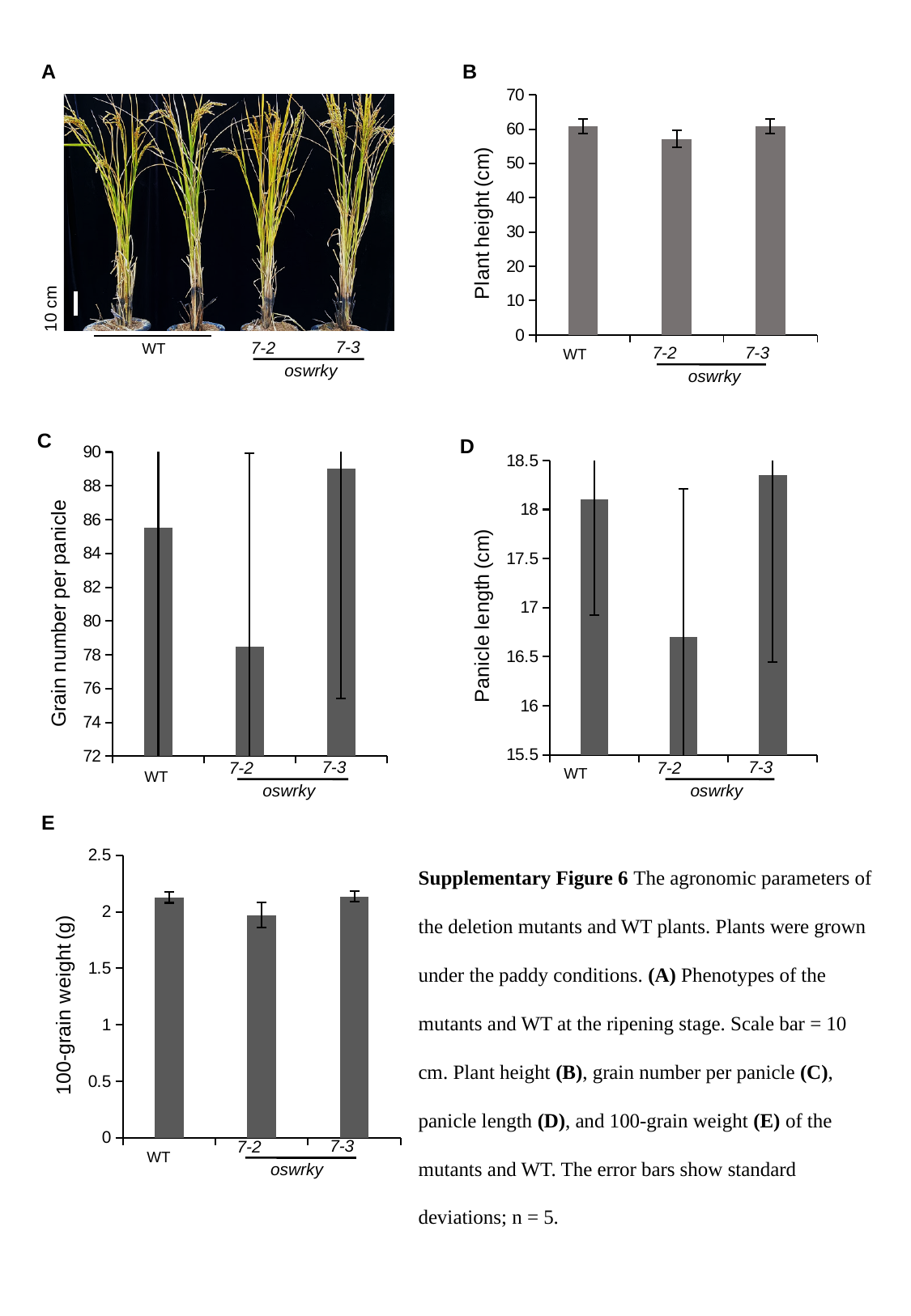
In chart B (Plant height), which category has the lowest plant height? 7-2 In chart B (Plant height), is the value for WT greater or less than 50? greater In chart B (Plant height), is the value for 7-2 greater or less than 60? less In chart E (100-grain weight), is the value for WT greater or less than 2? greater What kind of chart is chart C (Grain number per panicle)? bar chart In chart E (100-grain weight), which category has the lowest value? 7-2 How many categories are plotted in chart E (100-grain weight)? 3 In chart C (Grain number per panicle), which category has the lowest value? 7-2 In chart C (Grain number per panicle), which category has the highest value? 7-3 In chart D (Panicle length), which is larger, the value for WT or the value for 7-2? WT